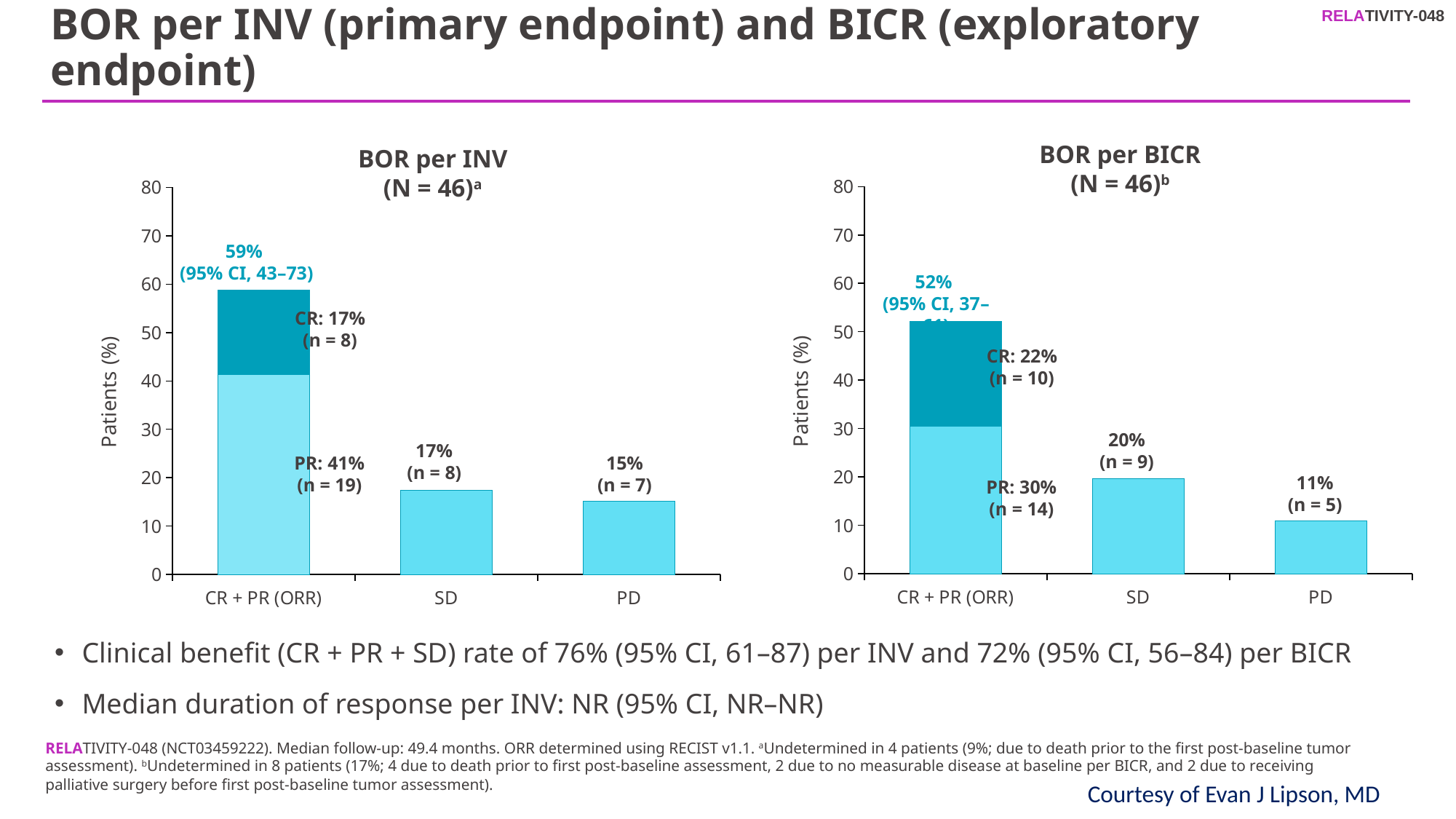
In the BOR per BICR chart, which category has the lowest value? PD In the BOR per INV chart, what is the ORR value shown for CR + PR? 59% What type of chart is the BOR per BICR chart? Bar chart What is the difference between the ORR in the BOR per INV chart and the ORR in the BOR per BICR chart? 7% In the BOR per BICR chart, what is the CR percentage within the CR + PR (ORR) bar? 22% In the BOR per INV chart, which category has the highest value? CR + PR (ORR) In the BOR per BICR chart, what is the difference between the SD and PD values? 9% In the BOR per BICR chart, what is the PD value? 11% In the BOR per INV chart, how many patients had a PR? n = 19 Is the SD value larger in the BOR per INV chart or the BOR per BICR chart? BOR per BICR In the BOR per INV chart, what percentage of patients had SD? 17% How many categories are shown on the x axis of the BOR per INV chart? 3